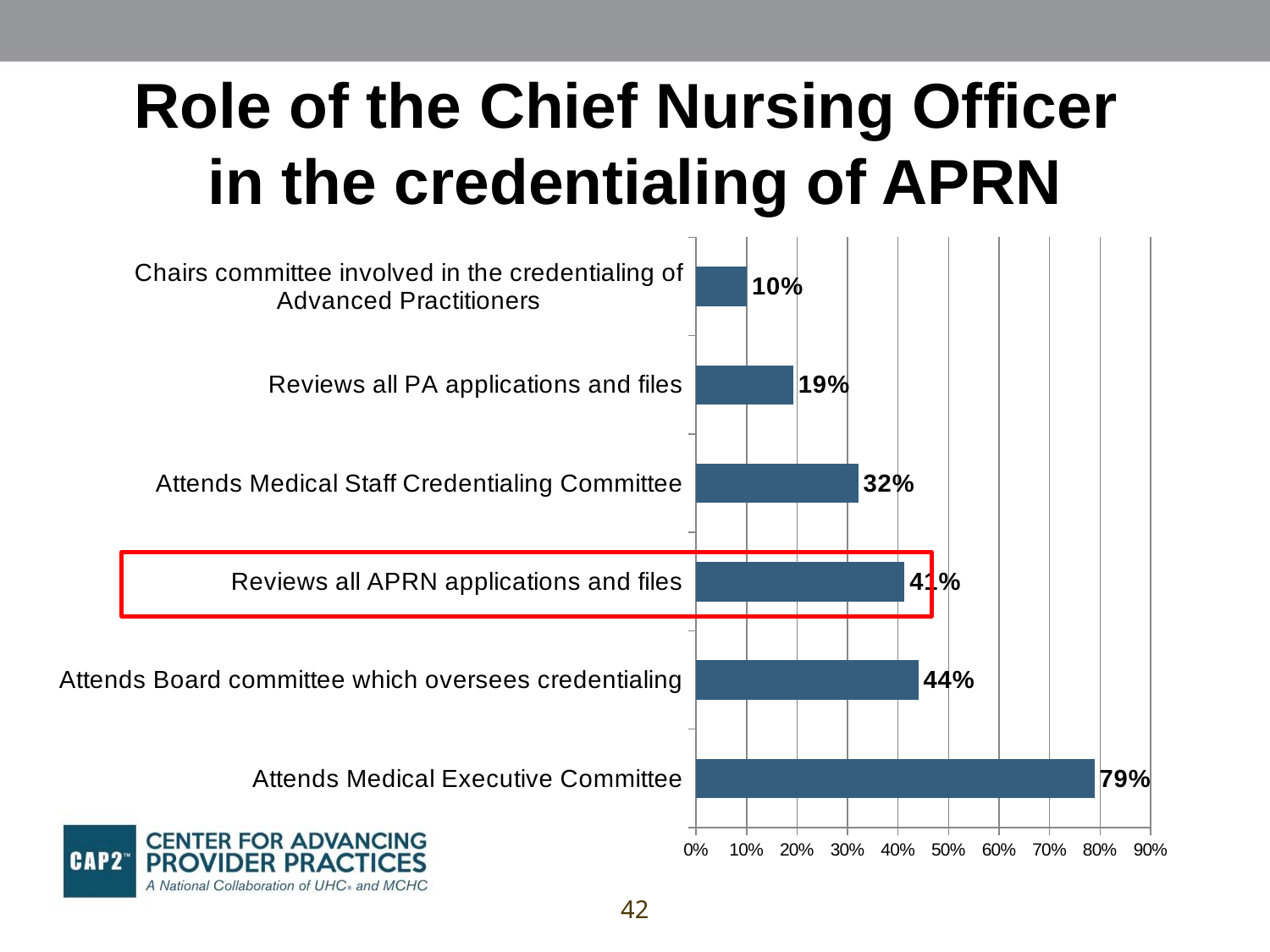
Which is larger: the value for "Attends Medical Staff Credentialing Committee" or the value for "Reviews all PA applications and files"? Attends Medical Staff Credentialing Committee What is the value for "Attends Medical Executive Committee"? 79% How many categories are plotted in the chart? 6 Which category has the lowest value? Chairs committee involved in the credentialing of Advanced Practitioners What is the value for "Chairs committee involved in the credentialing of Advanced Practitioners"? 10% What is the value for "Attends Medical Staff Credentialing Committee"? 32% Is the value for "Reviews all APRN applications and files" greater or less than 50%? less What is the value for "Reviews all PA applications and files"? 19% Which category has the highest value? Attends Medical Executive Committee What is the value for "Attends Board committee which oversees credentialing"? 44% What kind of chart is shown on the slide? bar chart What is the difference between the values for "Attends Medical Executive Committee" and "Attends Board committee which oversees credentialing"? 35%